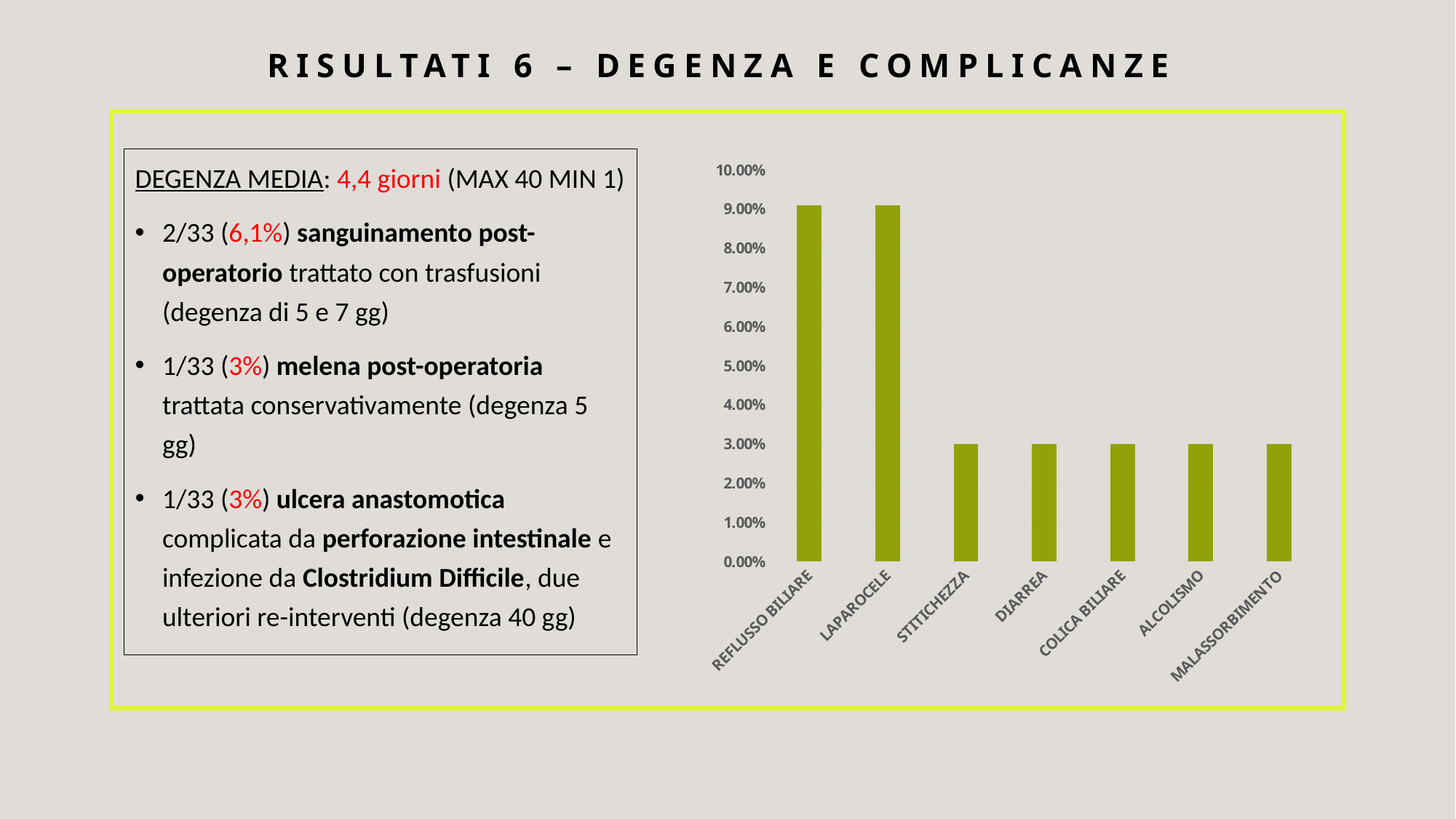
What is the highest value shown on the y axis of the chart? 10.00% What colour are the bars in the chart? green Which is larger, the value for COLICA BILIARE or the value for LAPAROCELE? LAPAROCELE Is the value for LAPAROCELE greater or less than 5.00%? greater How many categories are shown on the x axis of the chart? 7 What kind of chart is shown on the slide? bar chart Is the value for ALCOLISMO greater or less than 6.00%? less Is the value for DIARREA greater or less than 4.00%? less Which is larger, the value for REFLUSSO BILIARE or the value for STITICHEZZA? REFLUSSO BILIARE